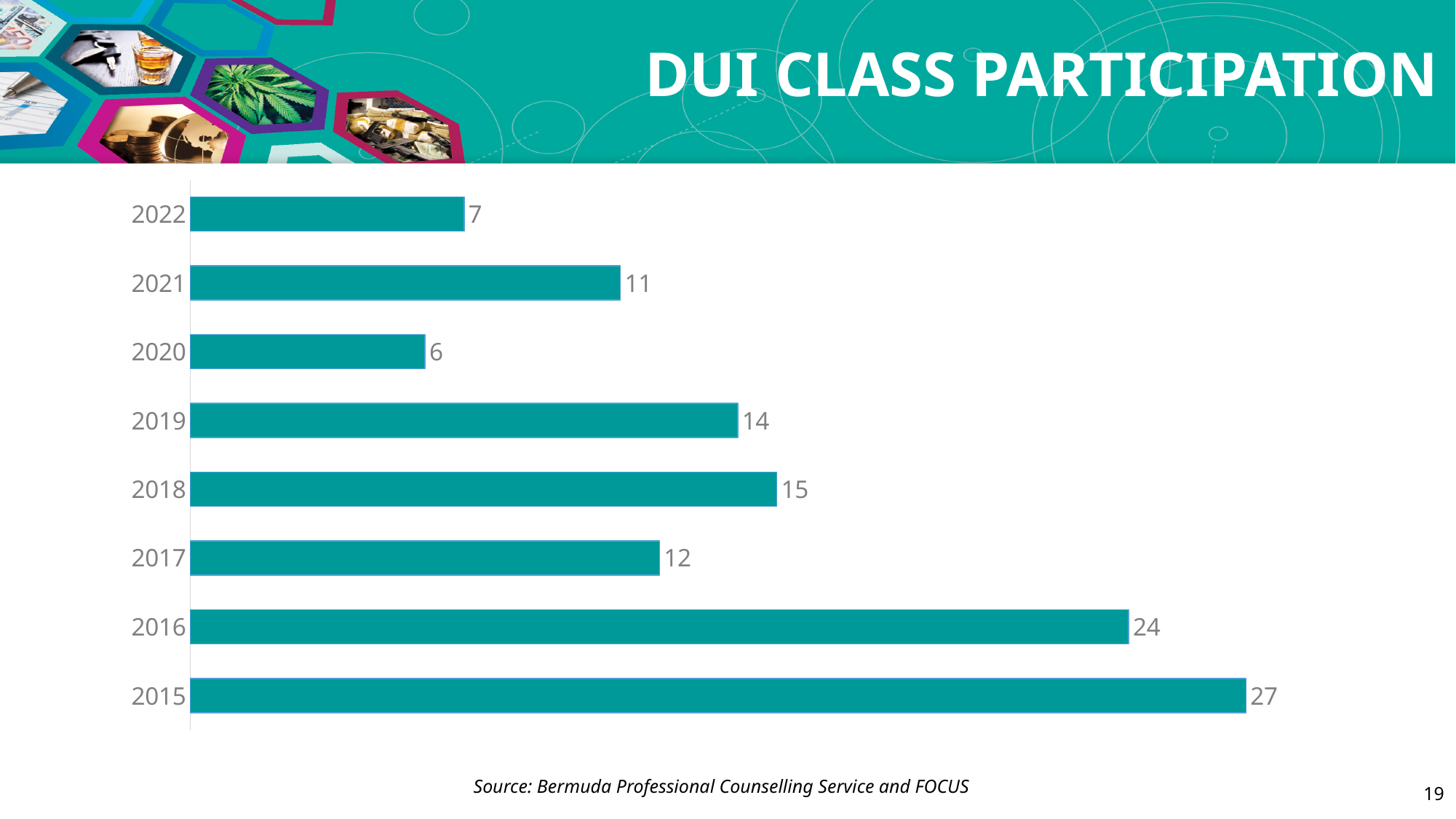
How many years are shown in the DUI class participation chart? 8 Which year has the lowest DUI class participation? 2020 What is the difference between the DUI class participation values for 2015 and 2022? 20 What kind of chart is used to show DUI class participation? Bar chart What is the difference between the DUI class participation values for 2016 and 2017? 12 Which year has a larger DUI class participation value, 2019 or 2021? 2019 What is the DUI class participation value for 2015? 27 What is the DUI class participation value for 2020? 6 What source is cited for the DUI class participation chart? Bermuda Professional Counselling Service and FOCUS Which year has the highest DUI class participation? 2015 What is the title of the chart on the slide? DUI CLASS PARTICIPATION What is the DUI class participation value for 2018? 15